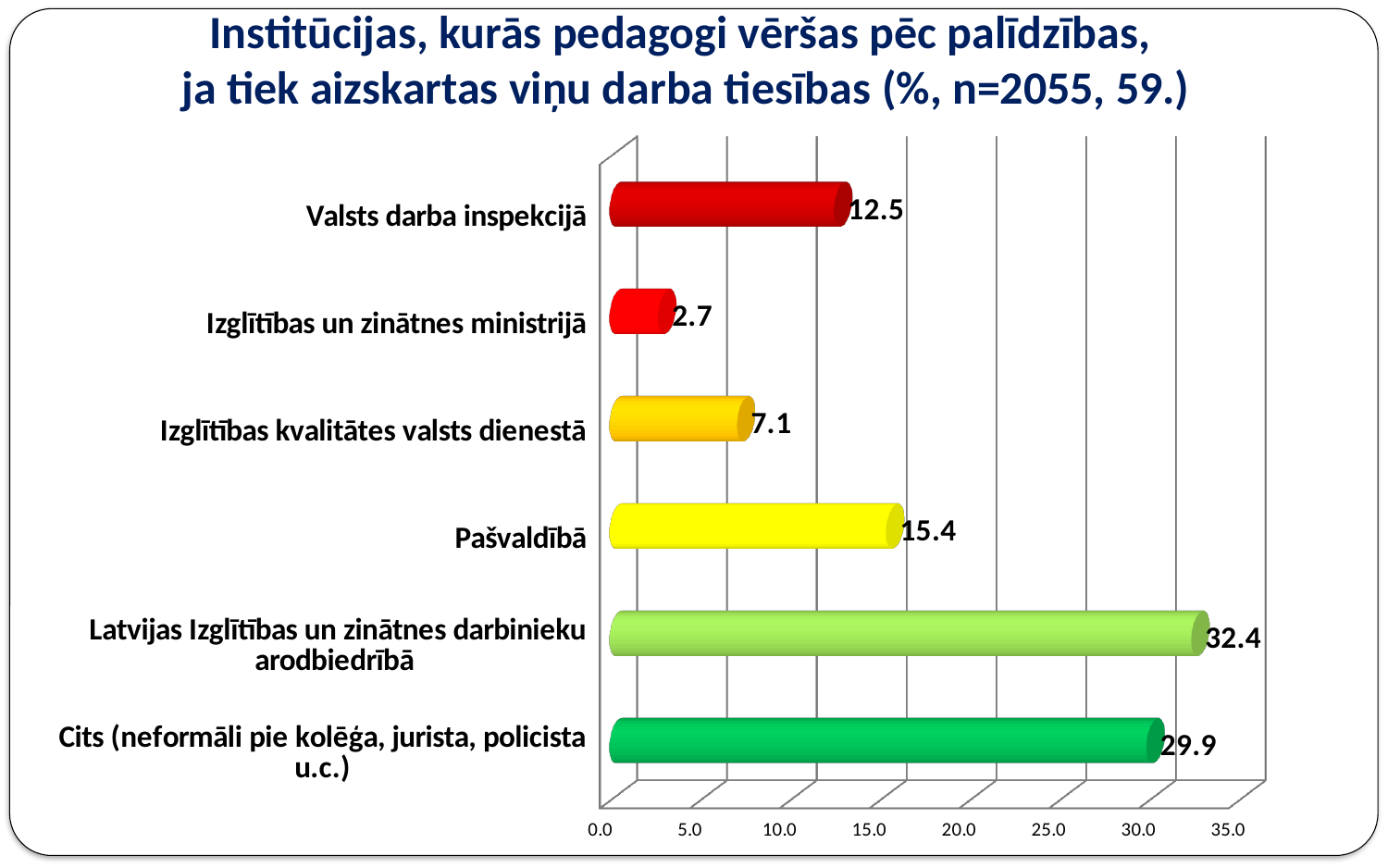
Which category has the lowest value? Izglītības un zinātnes ministrijā Which category has the highest value? Latvijas Izglītības un zinātnes darbinieku arodbiedrībā What is the value for Izglītības kvalitātes valsts dienestā? 7.1 What kind of chart is shown on the slide? bar chart Is the value for Cits (neformāli pie kolēģa, jurista, policista u.c.) greater or less than 25.0? greater Which is larger, the value for Pašvaldībā or the value for Valsts darba inspekcijā? Pašvaldībā What is the difference between the values for Latvijas Izglītības un zinātnes darbinieku arodbiedrībā and Cits (neformāli pie kolēģa, jurista, policista u.c.)? 2.5 What is the value for Valsts darba inspekcijā? 12.5 What is the value for Pašvaldībā? 15.4 How many categories are shown in the chart? 6 What is the difference between the values for Valsts darba inspekcijā and Izglītības un zinātnes ministrijā? 9.8 What is the value for Latvijas Izglītības un zinātnes darbinieku arodbiedrībā? 32.4